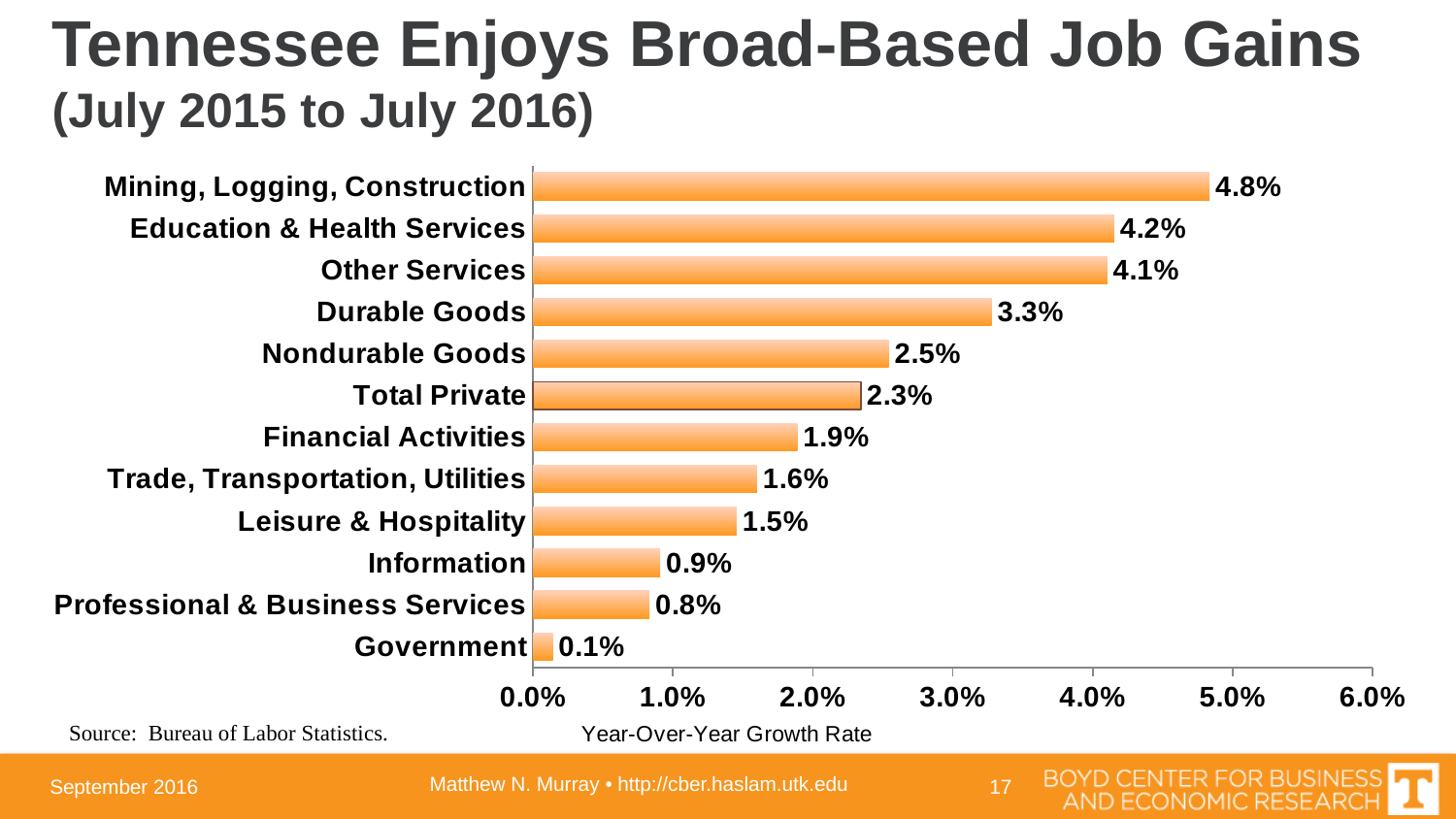
What is the year-over-year growth rate for Durable Goods? 3.3% Which sector has the highest year-over-year growth rate? Mining, Logging, Construction Is the value for Nondurable Goods greater or less than 2.0%? greater What is the year-over-year growth rate for Government? 0.1% What is the year-over-year growth rate for Total Private? 2.3% Which sector has the lowest year-over-year growth rate? Government What kind of chart is shown on the slide? Bar chart How many sectors are shown in the chart? 12 What is the label of the horizontal axis? Year-Over-Year Growth Rate What is the difference between the growth rates for Mining, Logging, Construction and Government? 4.7% Which has a higher growth rate, Financial Activities or Leisure & Hospitality? Financial Activities What is the difference between the growth rates for Education & Health Services and Other Services? 0.1%